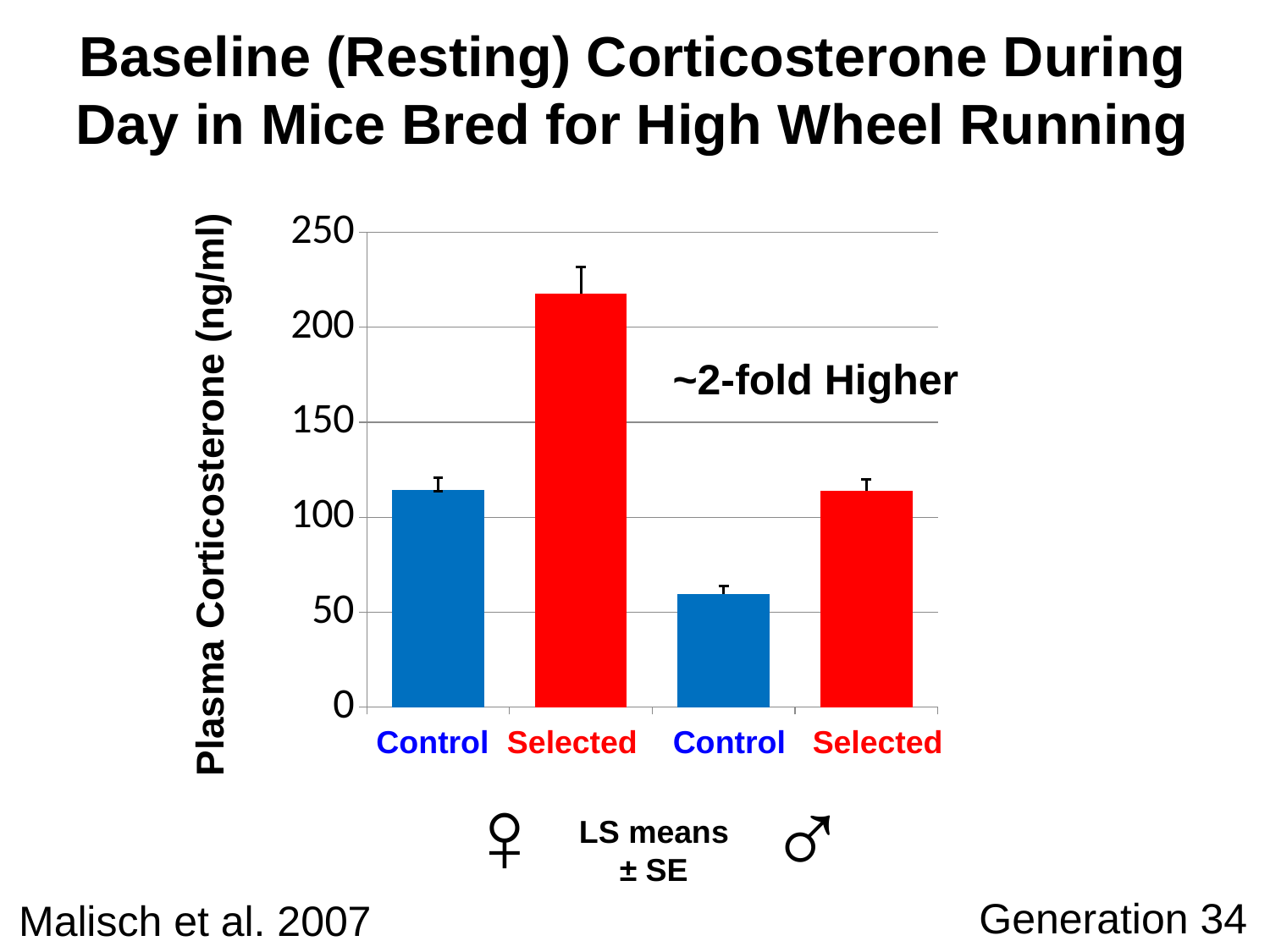
Which is larger, the female Selected bar or the female Control bar? female Selected How many bars are plotted in the chart? 4 Is the value for the female Selected bar greater or less than 200? greater What kind of chart is shown on the slide? bar chart Is the value for the female Control bar greater or less than 100? greater What is the label of the y axis? Plasma Corticosterone (ng/ml) Is the value for the male Control bar greater or less than 100? less Which is larger, the male Control bar or the male Selected bar? male Selected Which bar has the lowest plasma corticosterone value? Control (male) Which bar has the highest plasma corticosterone value? Selected (female) What annotation text is written inside the plot area of the chart? ~2-fold Higher